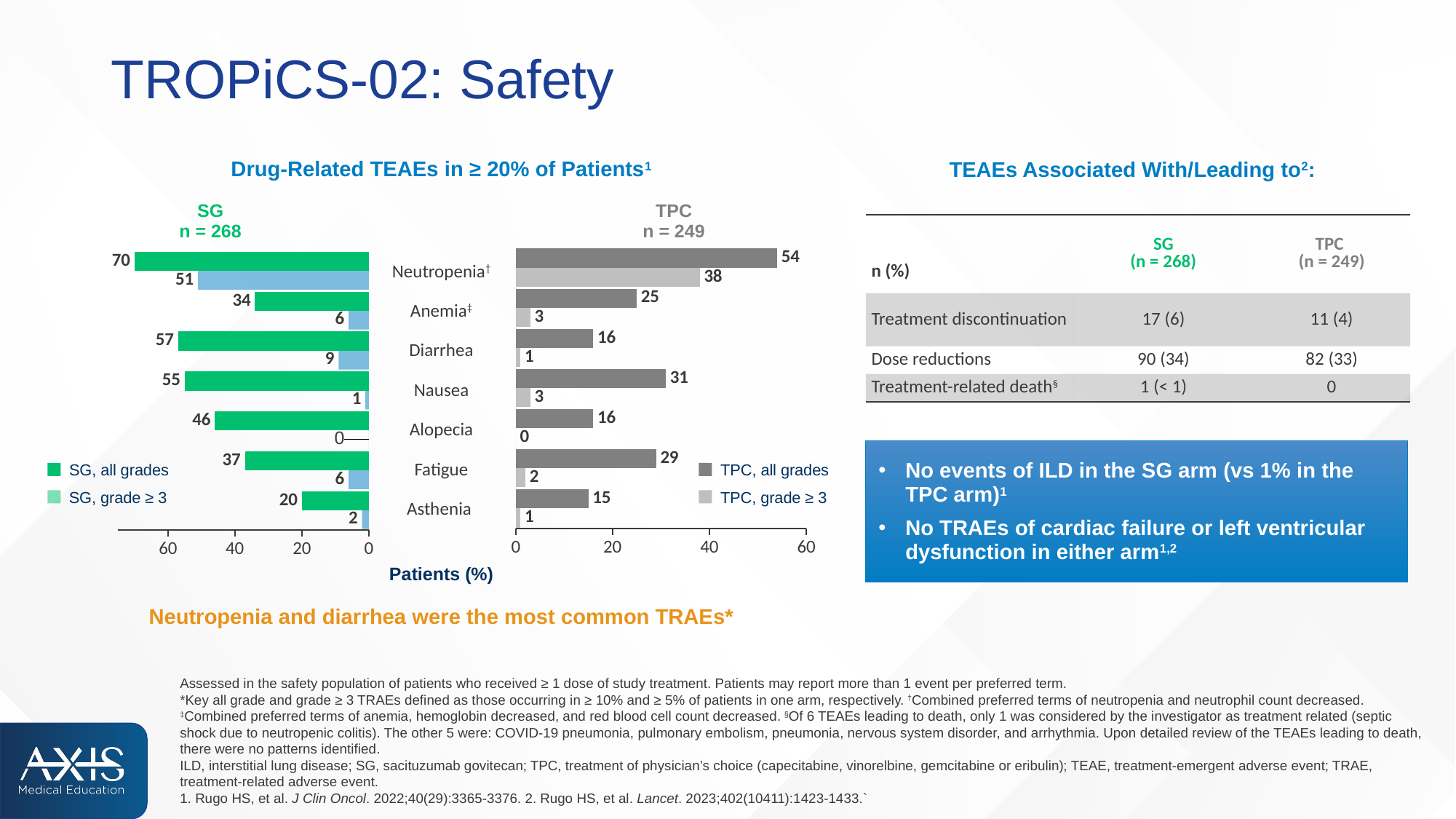
In the SG (n = 268) chart, what is the grade ≥ 3 value for Diarrhea? 9 Which is larger: the all-grades value for Diarrhea in the SG chart or in the TPC chart? SG In the TPC (n = 249) chart, is the all-grades value for Nausea greater or less than 20? greater What is the x-axis label shown beneath the SG and TPC charts? Patients (%) In the TPC (n = 249) chart, which category has the highest all-grades value? Neutropenia What type of chart is used to show the drug-related TEAEs? Bar chart In the TPC (n = 249) chart, what is the grade ≥ 3 value for Neutropenia? 38 In the SG (n = 268) chart, which category has the lowest all-grades value? Asthenia How many adverse event categories are shown in the SG (n = 268) chart? 7 In the SG (n = 268) chart, what is the difference between the all-grades and grade ≥ 3 values for Neutropenia? 19 How many series does the legend for the TPC chart list? 2 In the SG (n = 268) chart, what is the all-grades value for Neutropenia? 70